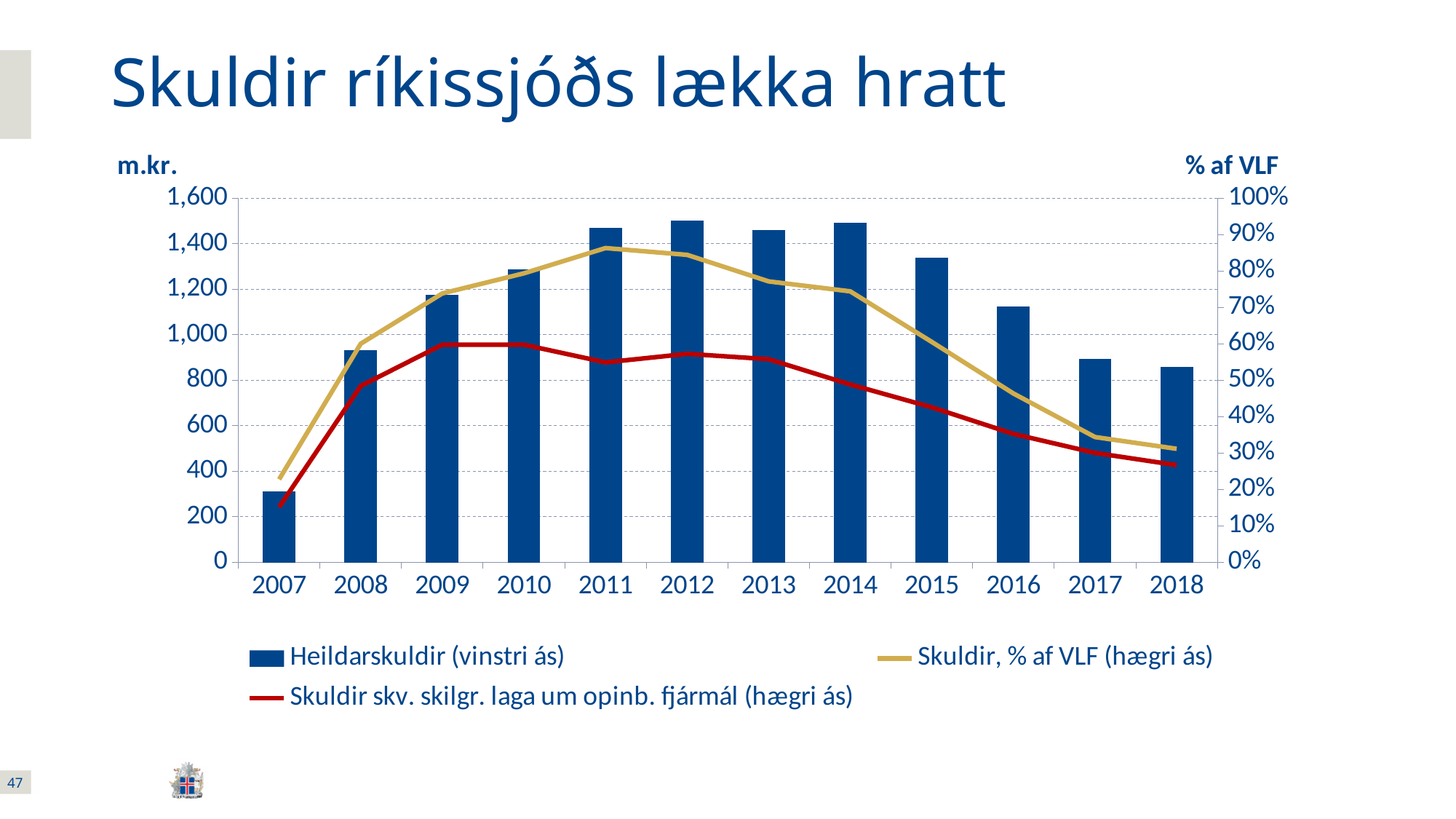
What is the title of the slide? Skuldir ríkissjóðs lækka hratt Is the Skuldir skv. skilgr. laga um opinb. fjármál value for 2018 greater or less than 30%? less Is the Heildarskuldir value for 2016 greater or less than 1,000? greater Which year has the larger Heildarskuldir bar, 2015 or 2016? 2015 Which year has the lowest Heildarskuldir bar? 2007 What kind of chart is shown on the slide? A combined bar and line chart Is the Skuldir, % af VLF value for 2007 greater or less than 30%? less Do the Heildarskuldir bars rise or fall from 2014 to 2018? fall How many series does the chart's legend list? 3 How many years are shown on the x axis of the chart? 12